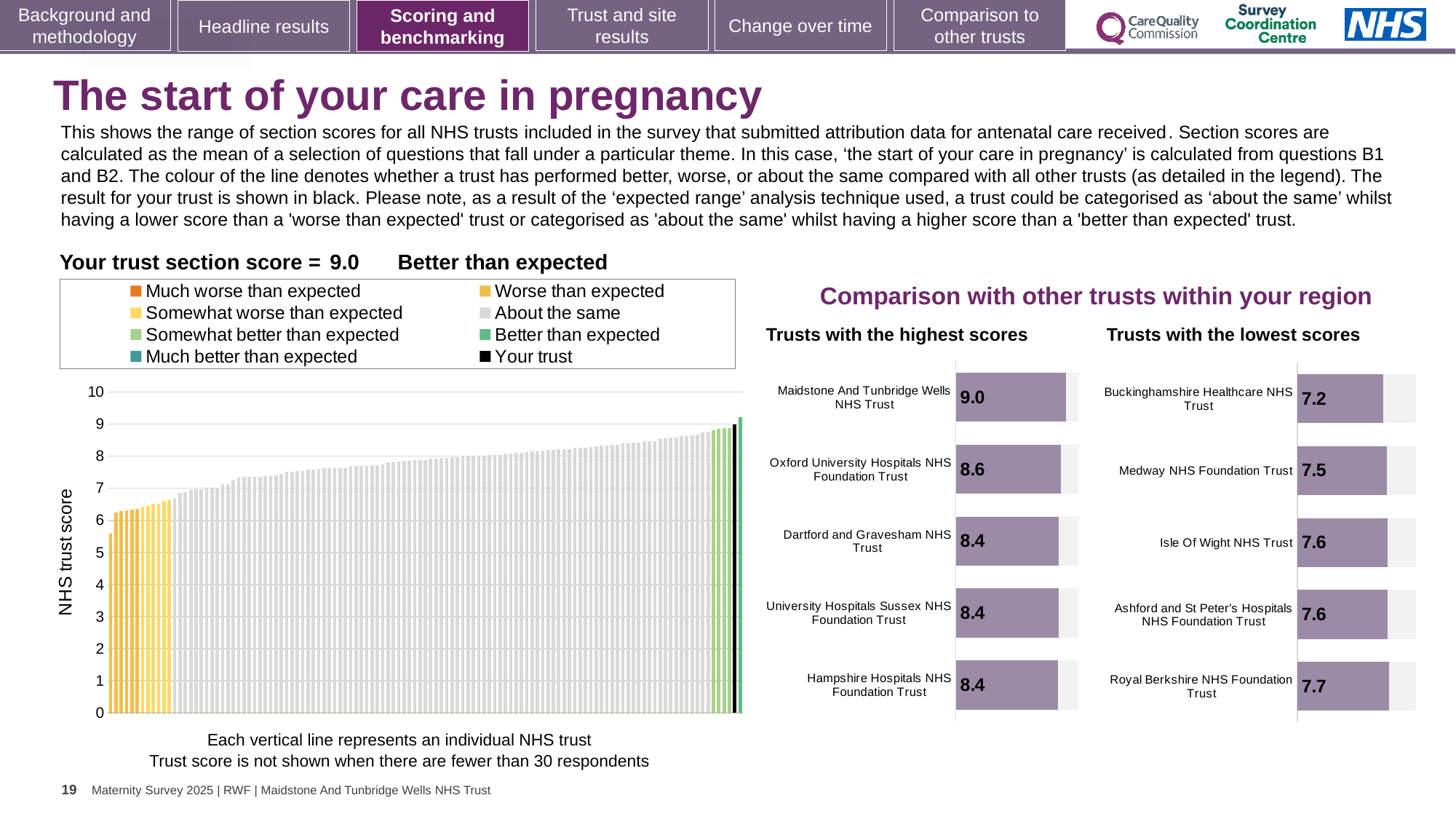
In the 'Trusts with the lowest scores' chart, what is the score for Medway NHS Foundation Trust? 7.5 In the 'Trusts with the highest scores' chart, which trust has the highest score? Maidstone And Tunbridge Wells NHS Trust In the NHS trust score chart, is the value of the leftmost bar greater or less than 7? less How many entries does the legend of the NHS trust score chart list? 8 In the 'Trusts with the highest scores' chart, what is the difference between the scores of Maidstone And Tunbridge Wells NHS Trust and Oxford University Hospitals NHS Foundation Trust? 0.4 What kind of chart is the NHS trust score chart on the left of the slide? bar chart In the 'Trusts with the lowest scores' chart, which trust has the lowest score? Buckinghamshire Healthcare NHS Trust In the NHS trust score chart, do the values rise or fall from left to right? rise In the 'Trusts with the lowest scores' chart, which has the higher score: Medway NHS Foundation Trust or Isle Of Wight NHS Trust? Isle Of Wight NHS Trust In the 'Trusts with the lowest scores' chart, what is the difference between the scores of Royal Berkshire NHS Foundation Trust and Buckinghamshire Healthcare NHS Trust? 0.5 In the 'Trusts with the highest scores' chart, what is the score for Oxford University Hospitals NHS Foundation Trust? 8.6 How many trusts are shown in the 'Trusts with the highest scores' chart? 5